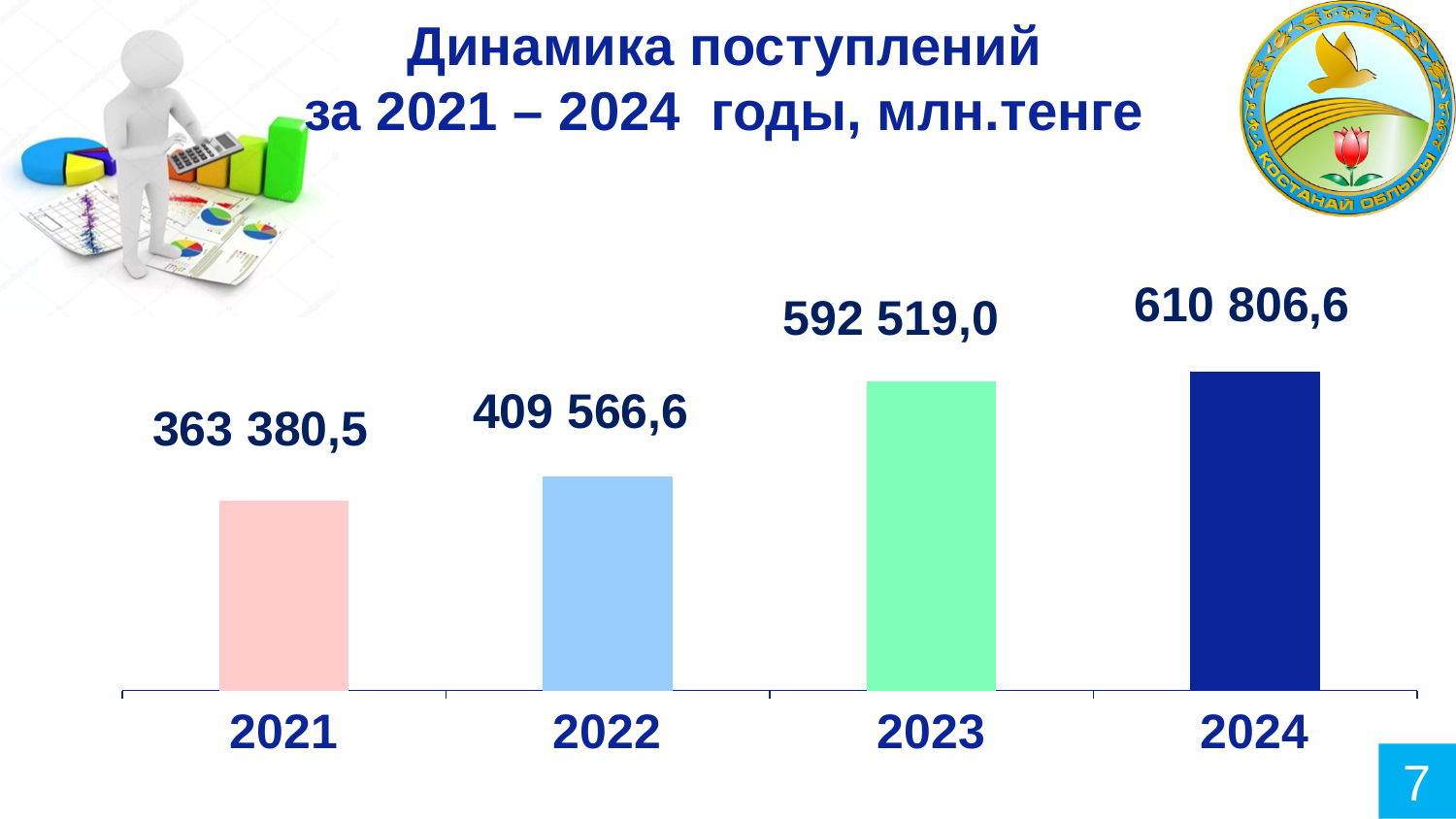
Which year has the highest value? 2024 What is the value shown for 2021? 363 380,5 Which year has the lowest value? 2021 Which is larger, the value for 2022 or the value for 2023? 2023 What is the value shown for 2023? 592 519,0 Do the values rise or fall from 2021 to 2024? Rise What is the difference between the values for 2022 and 2021? 46 186,1 What is the value shown for 2022? 409 566,6 What kind of chart is shown on the slide? Bar chart What is the value shown for 2024? 610 806,6 How many years are shown on the chart? 4 What is the difference between the values for 2024 and 2023? 18 287,6